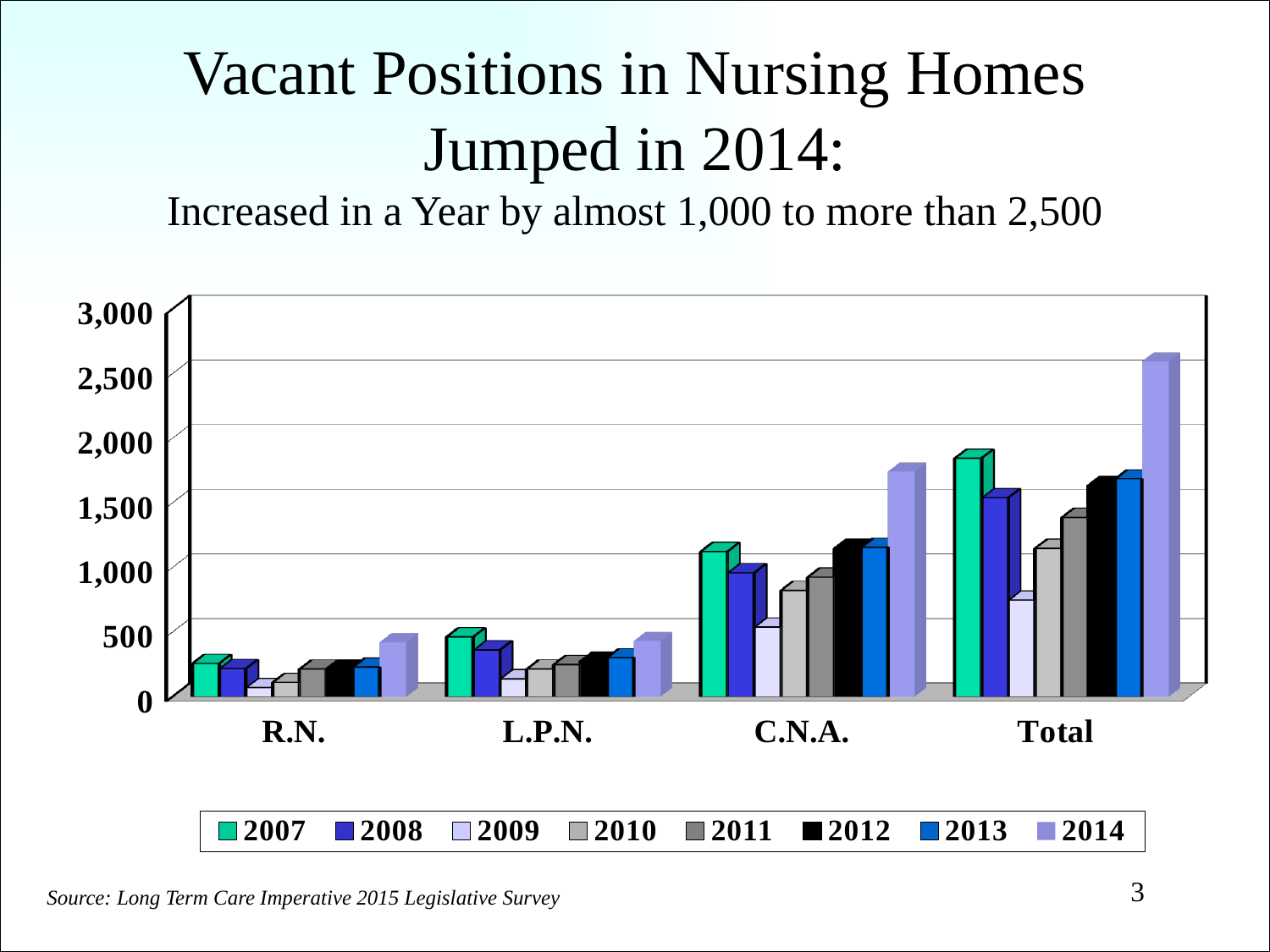
What kind of chart is shown on the slide? bar chart Is the value for Total in 2009 greater or less than 1,000? less Is the value for Total in 2007 greater or less than 2,000? less Which year has the highest bar in the Total category? 2014 Is the value for Total in 2014 greater or less than 2,500? greater How many series does the legend list? 8 In the Total category, which is larger, the 2007 bar or the 2008 bar? 2007 Which year has the lowest bar in the Total category? 2009 How many categories are shown on the x axis? 4 In the Total category, do the values rise or fall from 2009 to 2014? rise